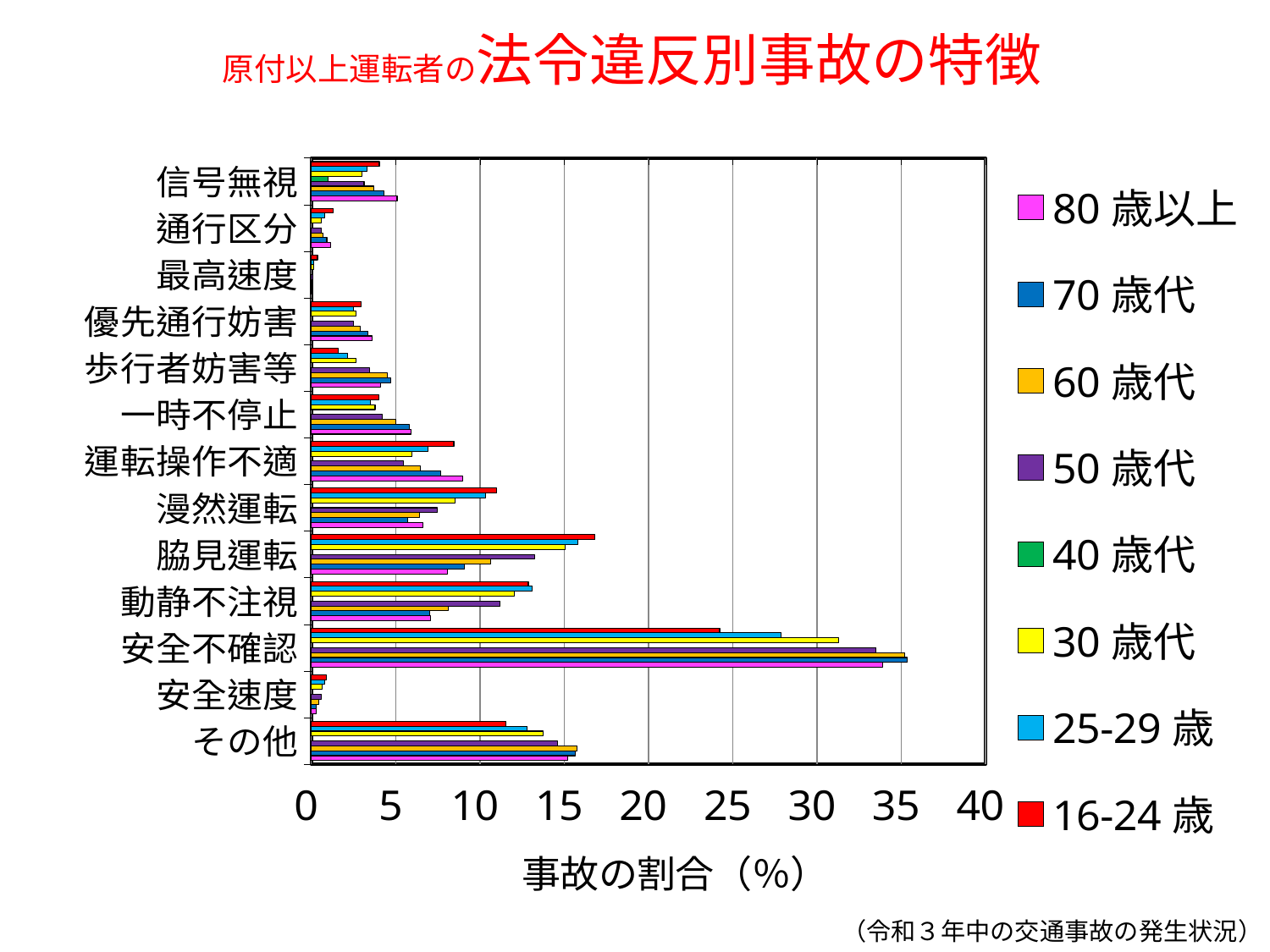
Is the value for 安全不確認 in the 70 歳代 series greater or less than 30? greater Which violation category has the highest accident share across the age groups? 安全不確認 What is the label of the horizontal axis of the chart? 事故の割合（%） How many violation categories are listed on the vertical axis of the chart? 13 For the 16-24 歳 series, which is larger: 安全不確認 or 脇見運転? 安全不確認 Is the value for 安全不確認 in the 16-24 歳 series greater or less than 20? greater Which violation category has the lowest accident share across the age groups? 最高速度 Is the value for 脇見運転 in the 16-24 歳 series greater or less than 15? greater How many series does the legend list? 8 What kind of chart is shown on the slide? bar chart For 安全不確認, which series has the larger value: 16-24 歳 or 80 歳以上? 80 歳以上